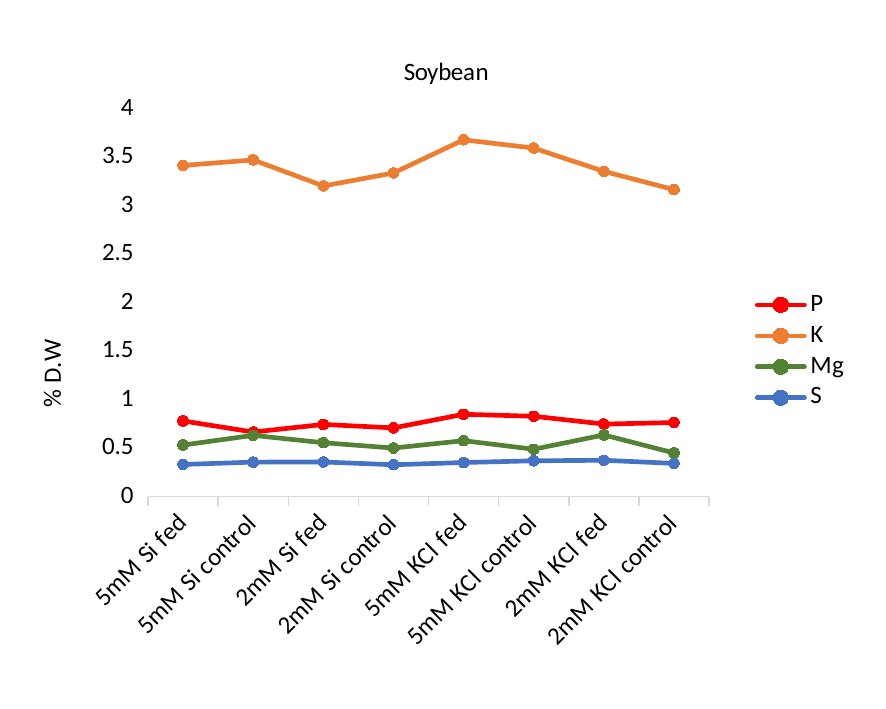
Is the value of K for 5mM KCl fed greater or less than 3.5? greater What kind of chart is shown on the slide? line chart Is the value of P for 5mM KCl fed greater or less than 0.5? greater Is the value of K for 2mM Si fed greater or less than 3.5? less How many series does the legend list? 4 What is the title of the chart? Soybean How many categories are shown along the x axis? 8 Which series has the highest values across all categories? K Do the values of K rise or fall from 5mM KCl fed to 2mM KCl control? fall Which is larger at 5mM Si control, the value for Mg or the value for S? Mg Which series has the lowest values across all categories? S